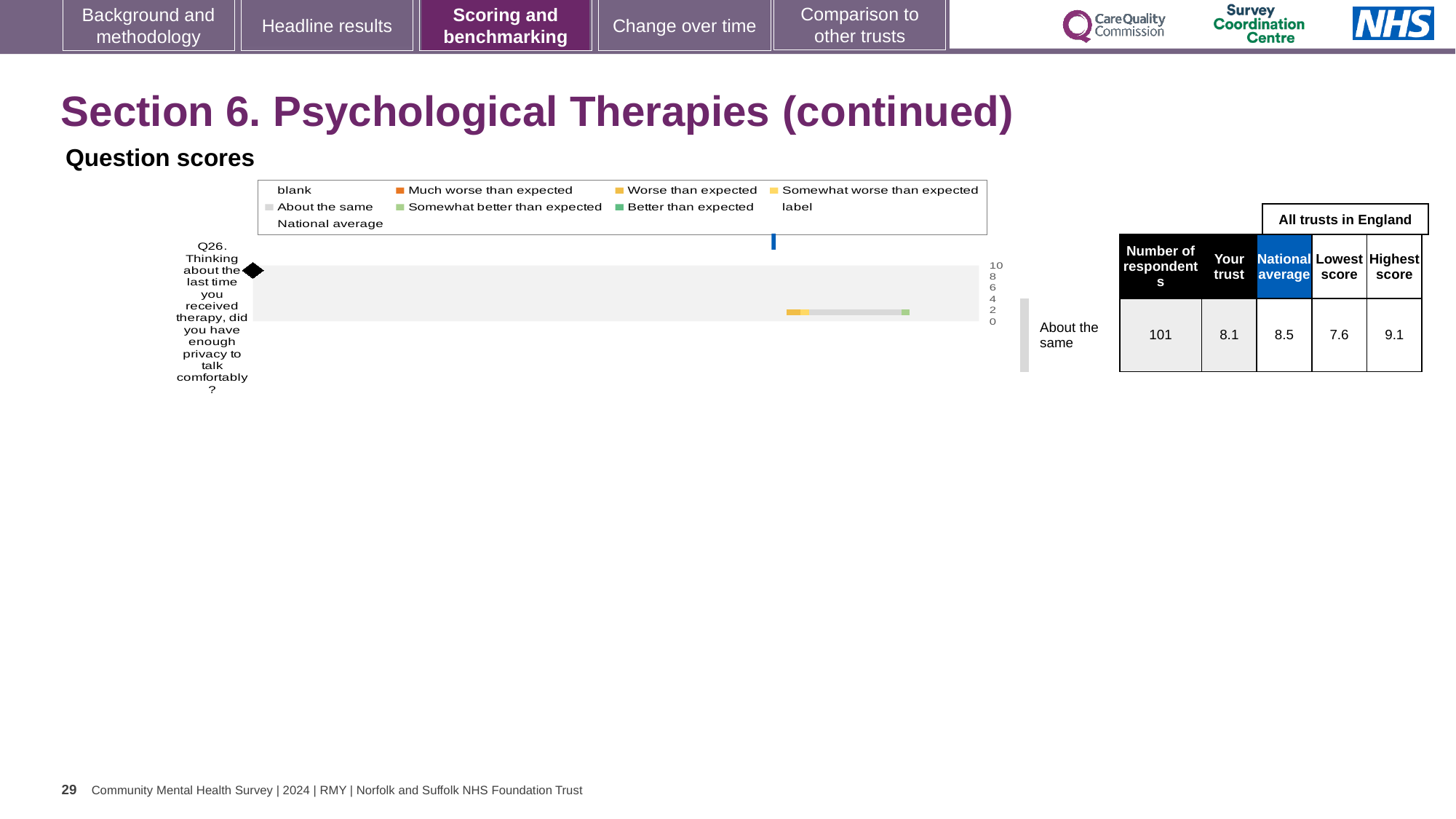
Which legend entry is shown with the darker green colour? Better than expected What is the 'Your trust' score for Q26 shown in the table next to the chart? 8.1 By how much does the national average exceed the 'Your trust' score for Q26? 0.4 What is the national average score for Q26? 8.5 What benchmark category is shown for Q26 beside the chart? About the same What is the difference between the highest score and the lowest score for Q26? 1.5 How many respondents answered Q26? 101 What kind of chart is used to show the Q26 question score? bar chart What is the lowest score among all trusts in England for Q26? 7.6 Which is larger for Q26, the 'Your trust' score or the national average? National average What is the highest score among all trusts in England for Q26? 9.1 How many survey questions are plotted in the Question scores chart? 1